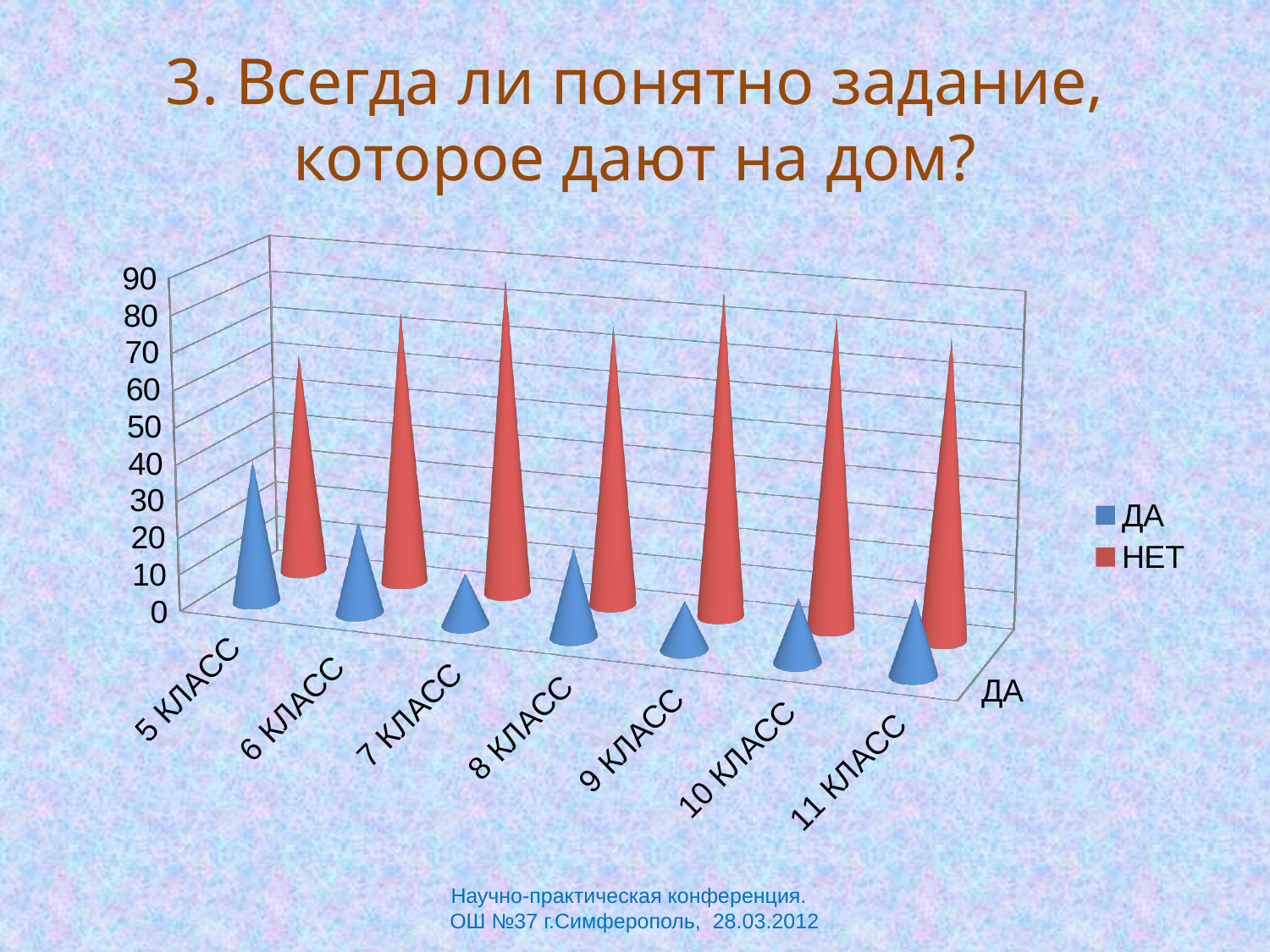
How many class categories are shown on the x axis of the chart? 7 How many series does the chart legend list? 2 What is the title of the slide containing the chart? 3. Всегда ли понятно задание, которое дают на дом? Which class has the highest ДА value? 5 КЛАСС Which series is shown in red in the chart? НЕТ Is the НЕТ value for 8 КЛАСС greater or less than 40? greater Is the НЕТ value for 5 КЛАСС greater or less than 30? greater Is the ДА value for 9 КЛАСС greater or less than 50? less What kind of chart is shown on the slide? bar chart For 5 КЛАСС, which is larger, the ДА value or the НЕТ value? НЕТ Do the ДА values rise or fall from 5 КЛАСС to 7 КЛАСС? fall